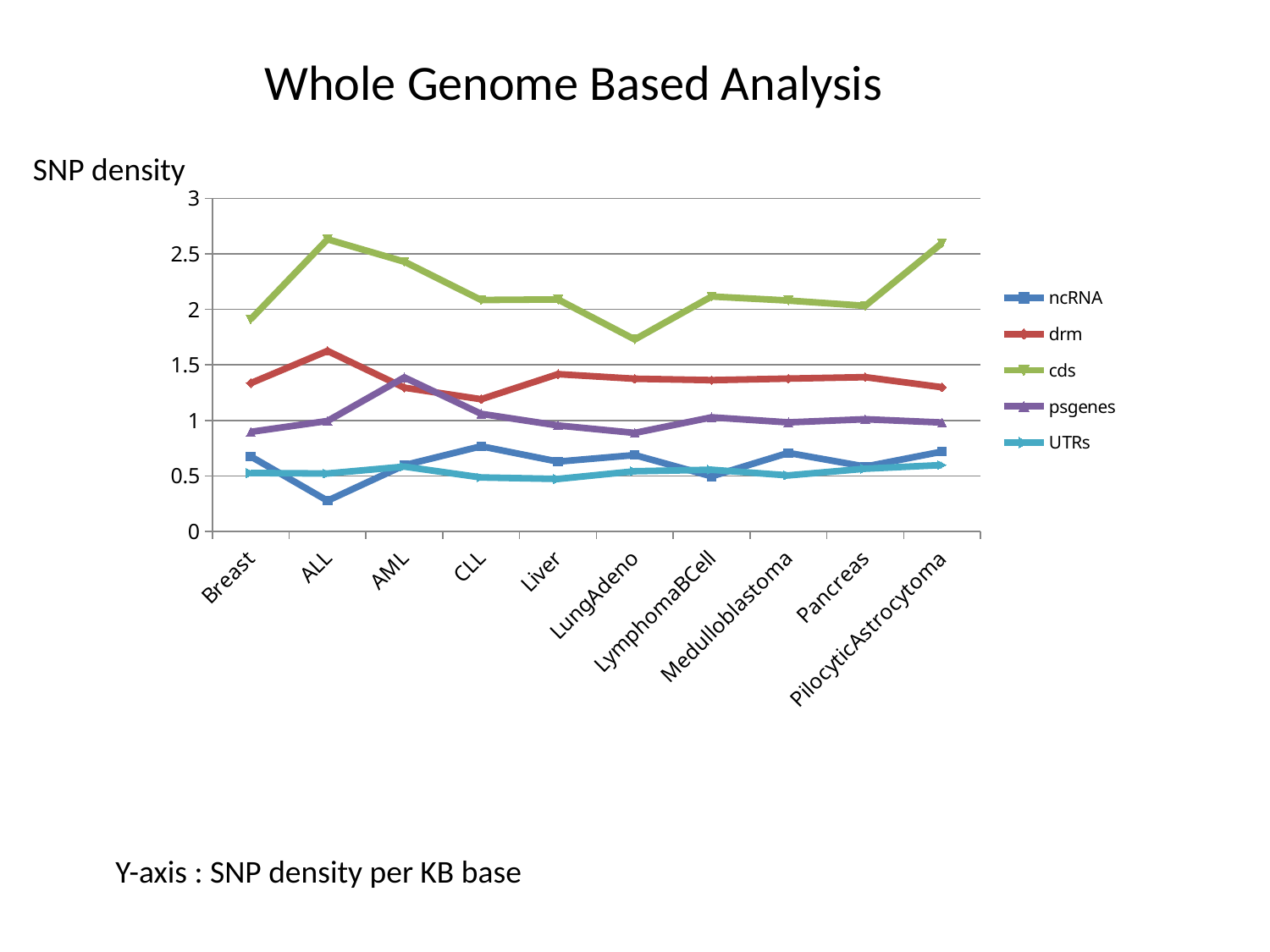
How many categories are shown along the x axis? 10 For which category is the cds series lowest? LungAdeno What kind of chart is shown on the slide? line chart Which is larger at ALL: the drm value or the psgenes value? drm Does the cds series rise or fall from Breast to ALL? rise How many series does the legend list? 5 Is the drm value for ALL greater or less than 1.5? greater For which category is the drm series highest? ALL For which category is the psgenes series highest? AML Is the cds value for Breast greater or less than 2? less Is the ncRNA value for ALL greater or less than 0.5? less For which category is the ncRNA series lowest? ALL